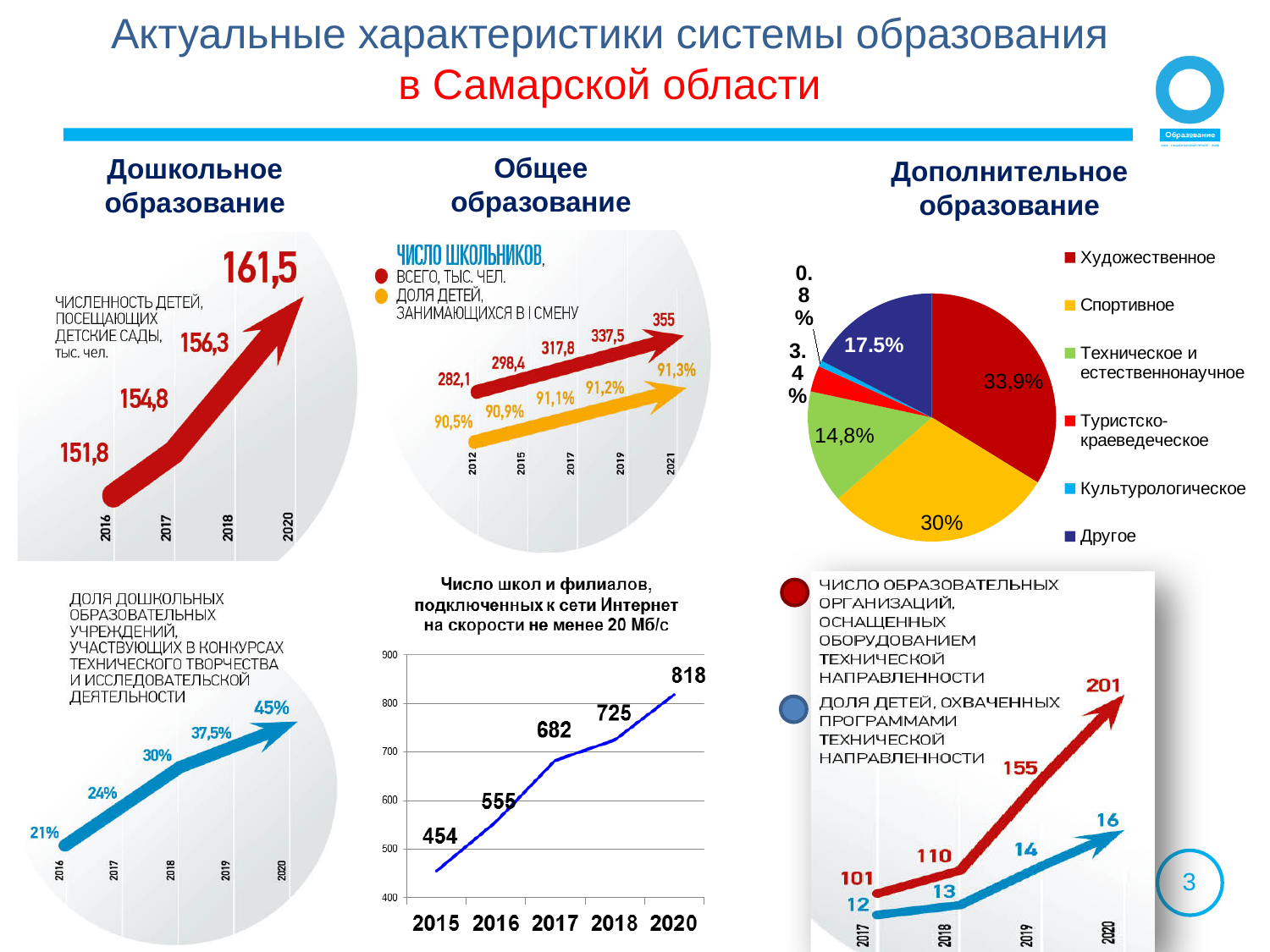
On the 'Число школ и филиалов, подключенных к сети Интернет' chart, what is the value for 2020? 818 On the pie chart under 'Дополнительное образование', which category has the largest slice? Художественное On the 'Численность детей, посещающих детские сады' chart, what is the value for 2018? 156,3 On the bottom-right chart, what is the number of educational organisations equipped with technical equipment in 2020? 201 On the 'Число школ и филиалов, подключенных к сети Интернет' chart, what is the difference between the 2017 and 2016 values? 127 On the 'Численность детей, посещающих детские сады' chart, do the values rise or fall from 2016 to 2020? rise On the 'Число школ и филиалов, подключенных к сети Интернет' chart, what kind of chart is shown? line chart How many entries does the legend of the pie chart under 'Дополнительное образование' list? 6 On the 'Число школьников' chart, what is the share of children studying in the first shift in 2012? 90,5% On the 'Число школьников' chart, what is the total number of schoolchildren (тыс. чел.) in 2021? 355 On the 'Доля дошкольных образовательных учреждений, участвующих в конкурсах' chart, what is the value for 2019? 37,5% On the pie chart under 'Дополнительное образование', what share does 'Спортивное' have? 30%